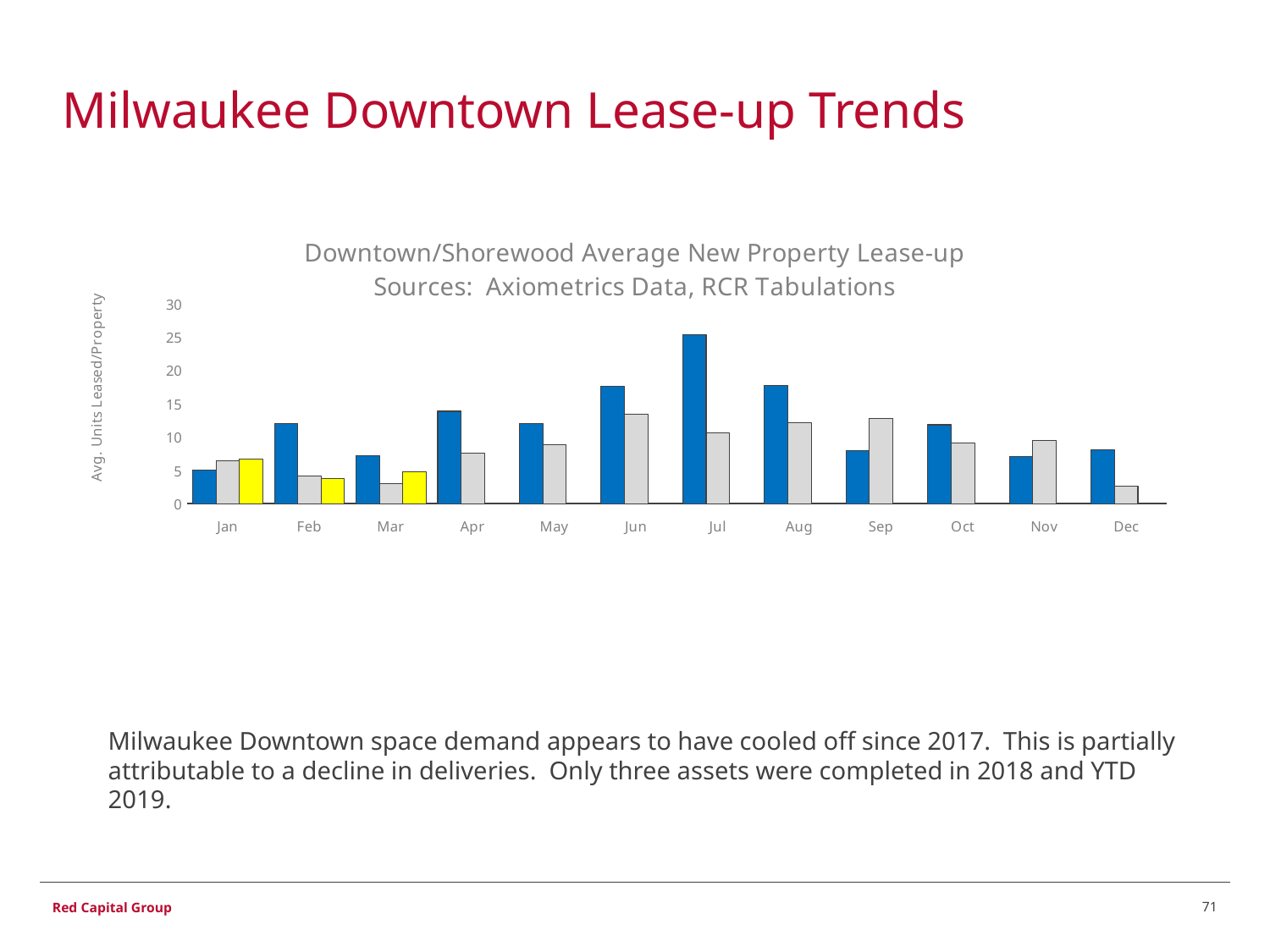
For Jun, which bar is taller, the blue bar or the gray bar? The blue bar What kind of chart is shown on the slide? Bar chart For Sep, which bar is taller, the blue bar or the gray bar? The gray bar In which month is the blue bar the shortest? Jan In how many months does a yellow bar appear? 3 How many months are shown along the x axis of the chart? 12 Is the value of the gray bar for Feb greater or less than 5? less Is the value of the gray bar for Dec greater or less than 5? less In which month is the blue bar the tallest? Jul Is the value of the blue bar for Jul greater or less than 20? greater What is the label on the y axis of the chart? Avg. Units Leased/Property